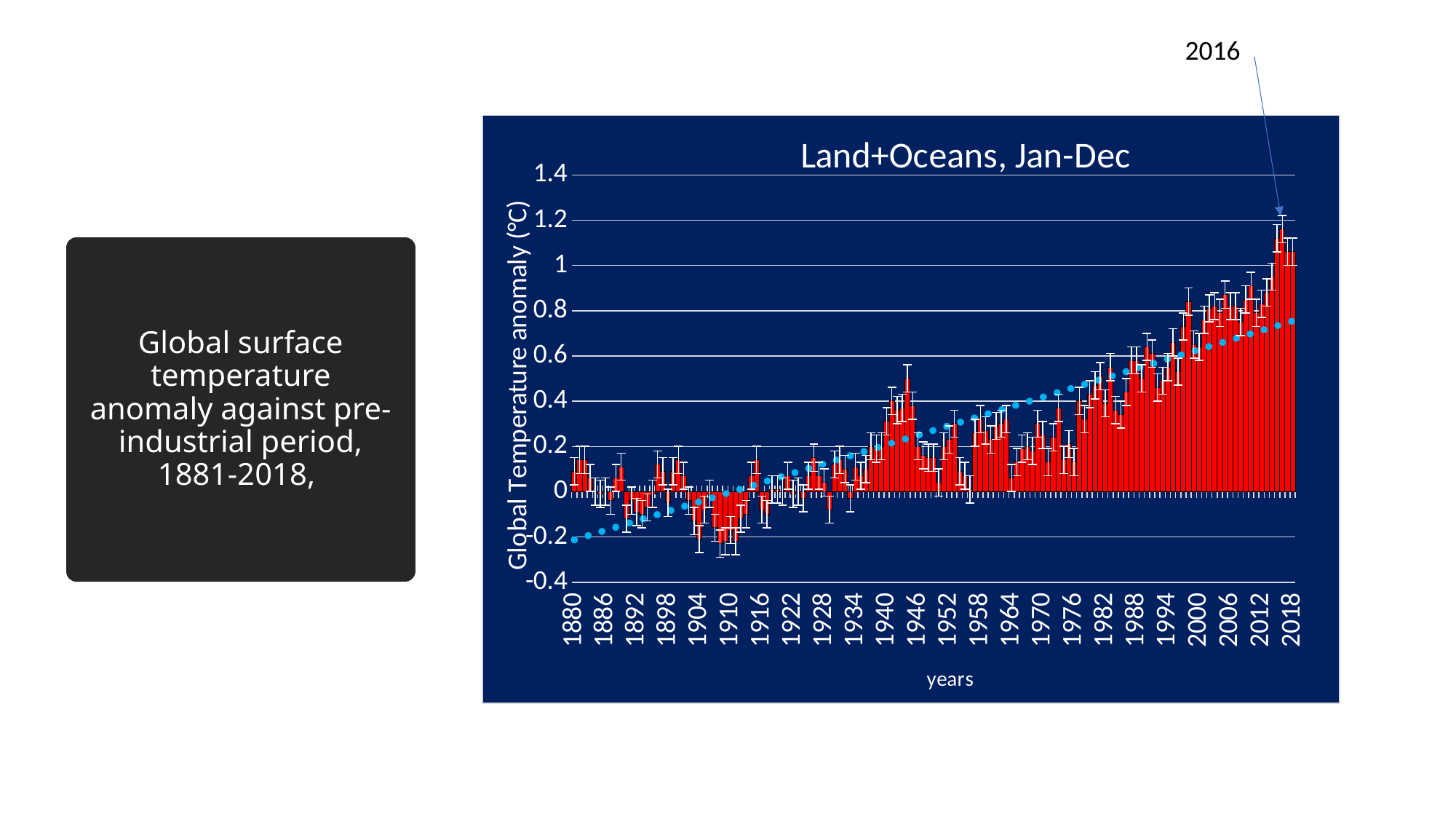
Which year has the larger temperature anomaly, 1910 or 1940? 1940 Is the value for 2016 greater or less than 1? greater What is the label of the vertical axis of the chart? Global Temperature anomaly (°C) What kind of chart is shown on the slide? bar chart Overall, do the temperature anomaly values rise or fall from 1880 to 2018? rise Is the value for 1910 greater or less than 0? less Is the value for 2018 greater or less than 0.8? greater Which year has the highest global temperature anomaly in the chart? 2016 Which year has the larger temperature anomaly, 1880 or 2016? 2016 What is the title of the chart? Land+Oceans, Jan-Dec